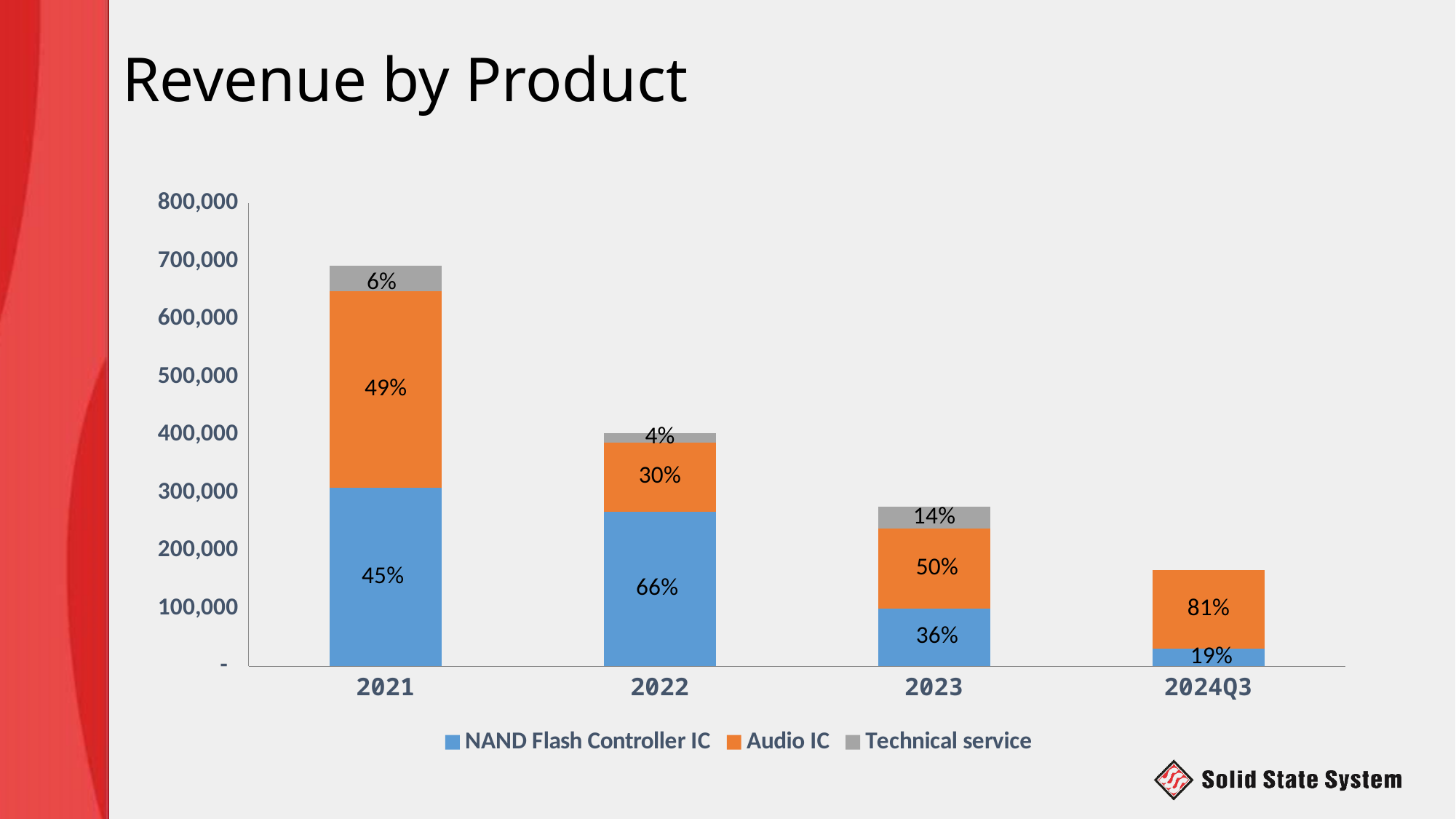
What percentage share does Audio IC have in 2021? 49% How many series does the legend list? 3 Does total revenue rise or fall from 2021 to 2024Q3? fall Is the total revenue for 2021 greater or less than 600,000? greater What is the title of the chart? Revenue by Product What percentage share does Technical service have in 2023? 14% What type of chart is shown on the slide? stacked bar chart Which year has the tallest total revenue bar? 2021 What percentage share does NAND Flash Controller IC have in 2022? 66% What percentage share does Audio IC have in 2024Q3? 81% Which period has the shortest total revenue bar? 2024Q3 How many periods are shown on the x axis? 4